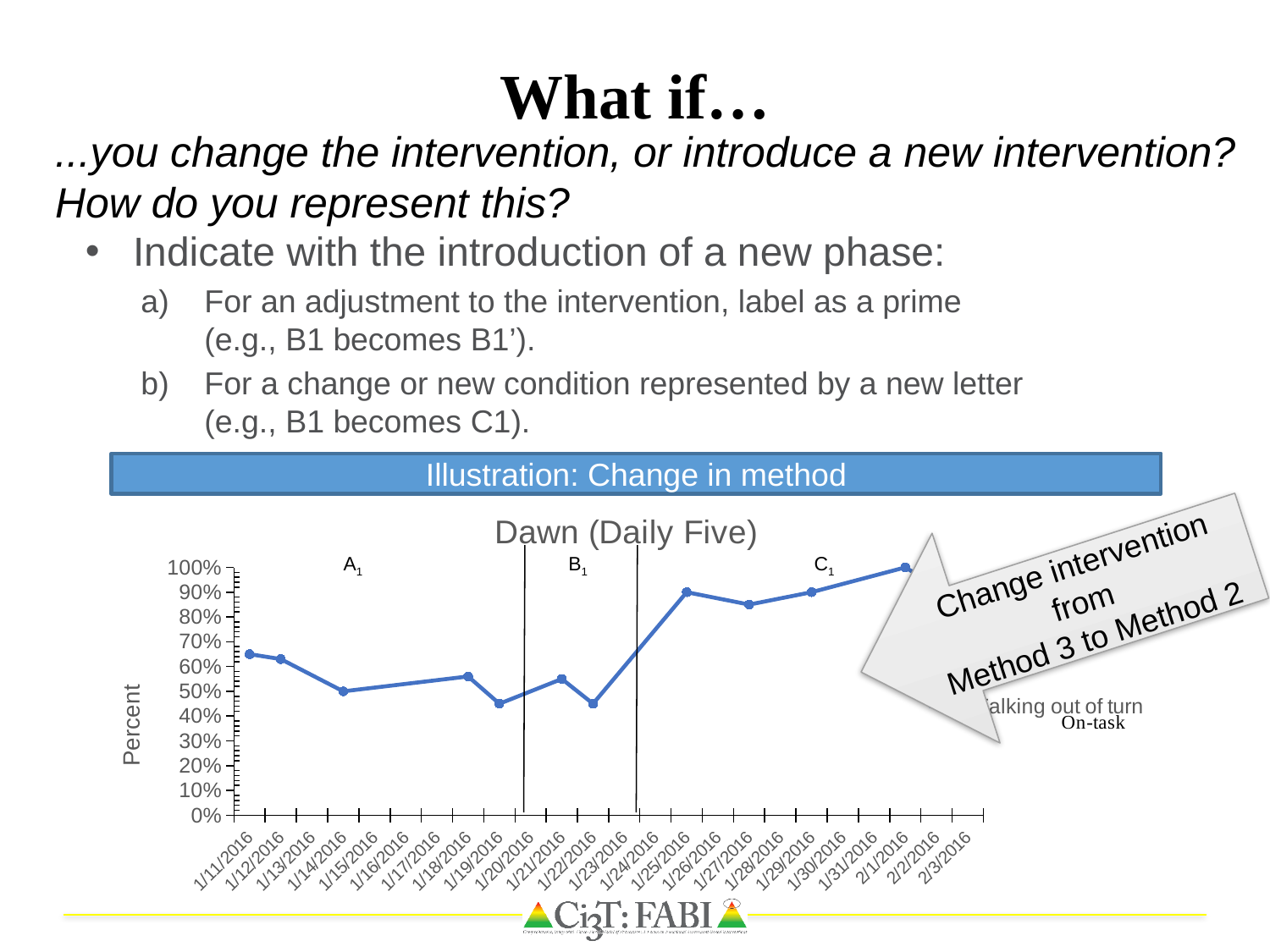
Do the values in phase C1 lie above or below the values in phase A1? above On which date does the plotted line reach its highest value? 2/1/2016 Is the value for 1/11/2016 greater or less than 60%? greater Is the value for 1/27/2016 greater or less than 80%? greater Which is larger, the value for 1/25/2016 or the value for 1/14/2016? 1/25/2016 What is the title of the chart? Dawn (Daily Five) What is the label on the vertical axis of the chart? Percent What kind of chart is shown on the slide? line chart What is the value plotted for 2/1/2016? 100% Is the value for 1/19/2016 greater or less than 50%? less How many phases (A1, B1, C1) are marked on the chart? 3